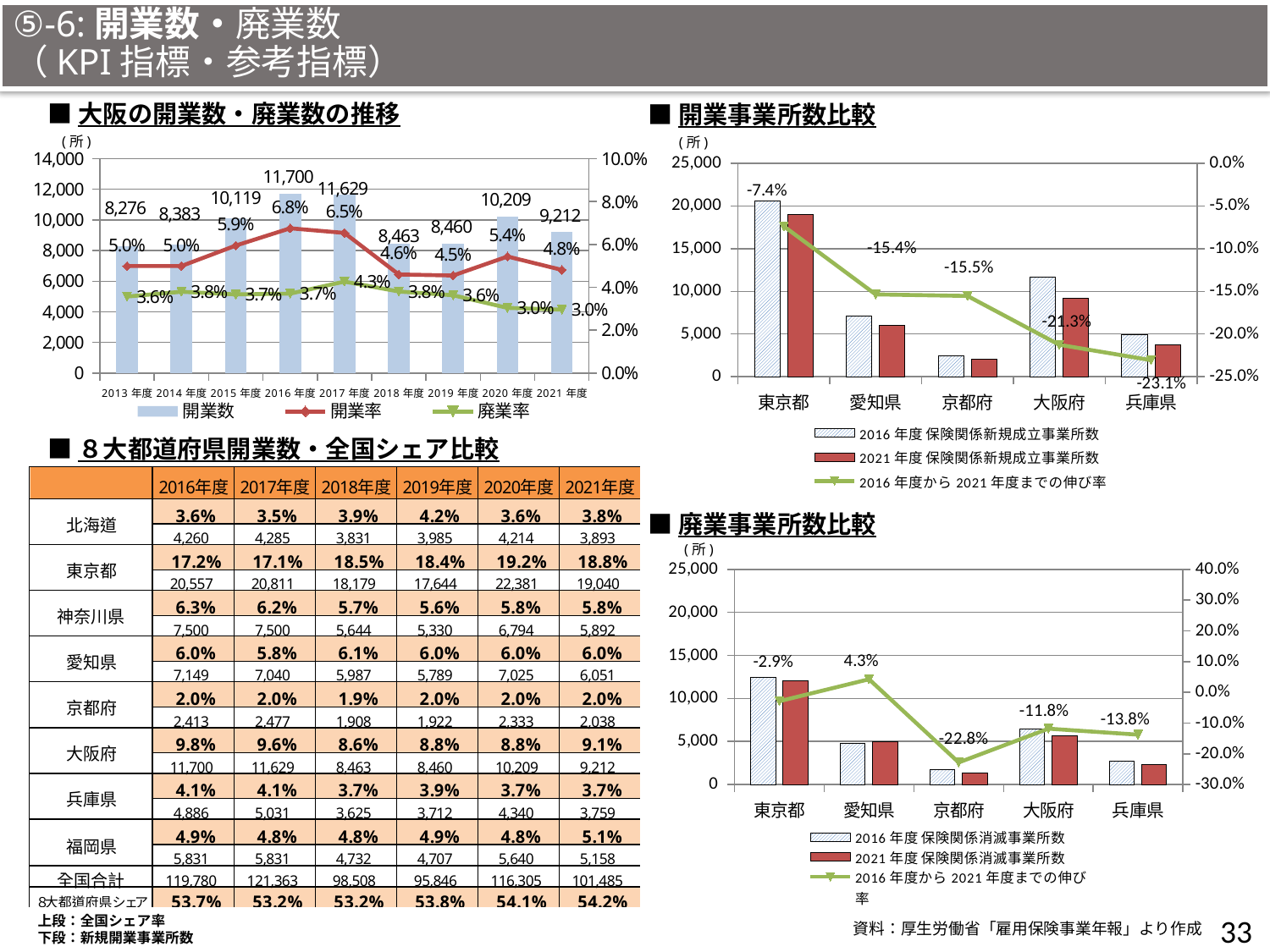
In the chart titled 大阪の開業数・廃業数の推移, what is the difference between the 開業数 for 2016年度 and 2021年度? 2,488 In the chart titled 開業事業所数比較, is the 2016年度 value for 東京都 greater or less than 20,000? greater In the chart titled 大阪の開業数・廃業数の推移, what is the 開業数 value for 2016年度? 11,700 In the chart titled 開業事業所数比較, which prefecture has the lowest 伸び率? 兵庫県 In the chart titled 廃業事業所数比較, what is the 伸び率 for 京都府? -22.8% In the chart titled 大阪の開業数・廃業数の推移, what is the 開業率 for 2018年度? 4.6% In the chart titled 大阪の開業数・廃業数の推移, which year has the lowest 開業数? 2013年度 In the chart titled 廃業事業所数比較, which prefecture has the highest 伸び率? 愛知県 In the chart titled 開業事業所数比較, what is the 2016年度から2021年度までの伸び率 for 大阪府? -21.3% In the chart titled 大阪の開業数・廃業数の推移, does the 廃業率 rise or fall from 2017年度 to 2021年度? fall In the chart titled 廃業事業所数比較, how many prefectures are shown on the x axis? 5 In the chart titled 大阪の開業数・廃業数の推移, how many series does the legend list? 3